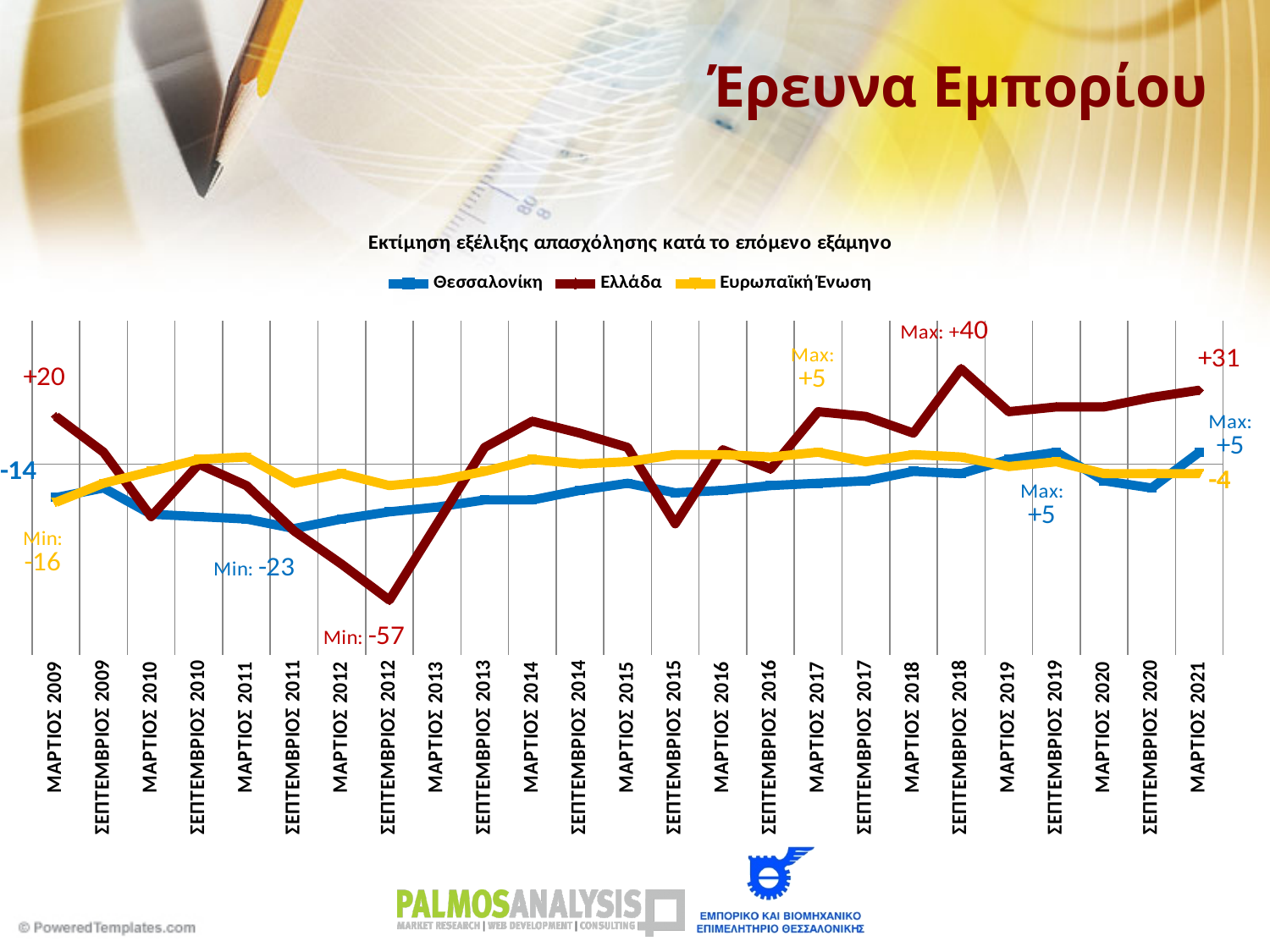
What is the minimum value of the Θεσσαλονίκη series? -23 Which colour represents the Ευρωπαϊκή Ένωση series? Yellow What type of chart is shown on the slide? Line chart How many time periods are shown on the x axis? 25 What is the value for Ευρωπαϊκή Ένωση at ΜΑΡΤΙΟΣ 2021? -4 What is the minimum value of the Ελλάδα series? -57 What is the value for Θεσσαλονίκη at ΜΑΡΤΙΟΣ 2009? -14 Which series has the higher value at ΜΑΡΤΙΟΣ 2021, Ελλάδα or Ευρωπαϊκή Ένωση? Ελλάδα What is the value for Ελλάδα at ΜΑΡΤΙΟΣ 2021? +31 How many series does the legend list? 3 What is the maximum value reached by the Ελλάδα series, and in which period? +40, ΣΕΠΤΕΜΒΡΙΟΣ 2018 What is the difference between the Ελλάδα value and the Θεσσαλονίκη value at ΜΑΡΤΙΟΣ 2021? 26